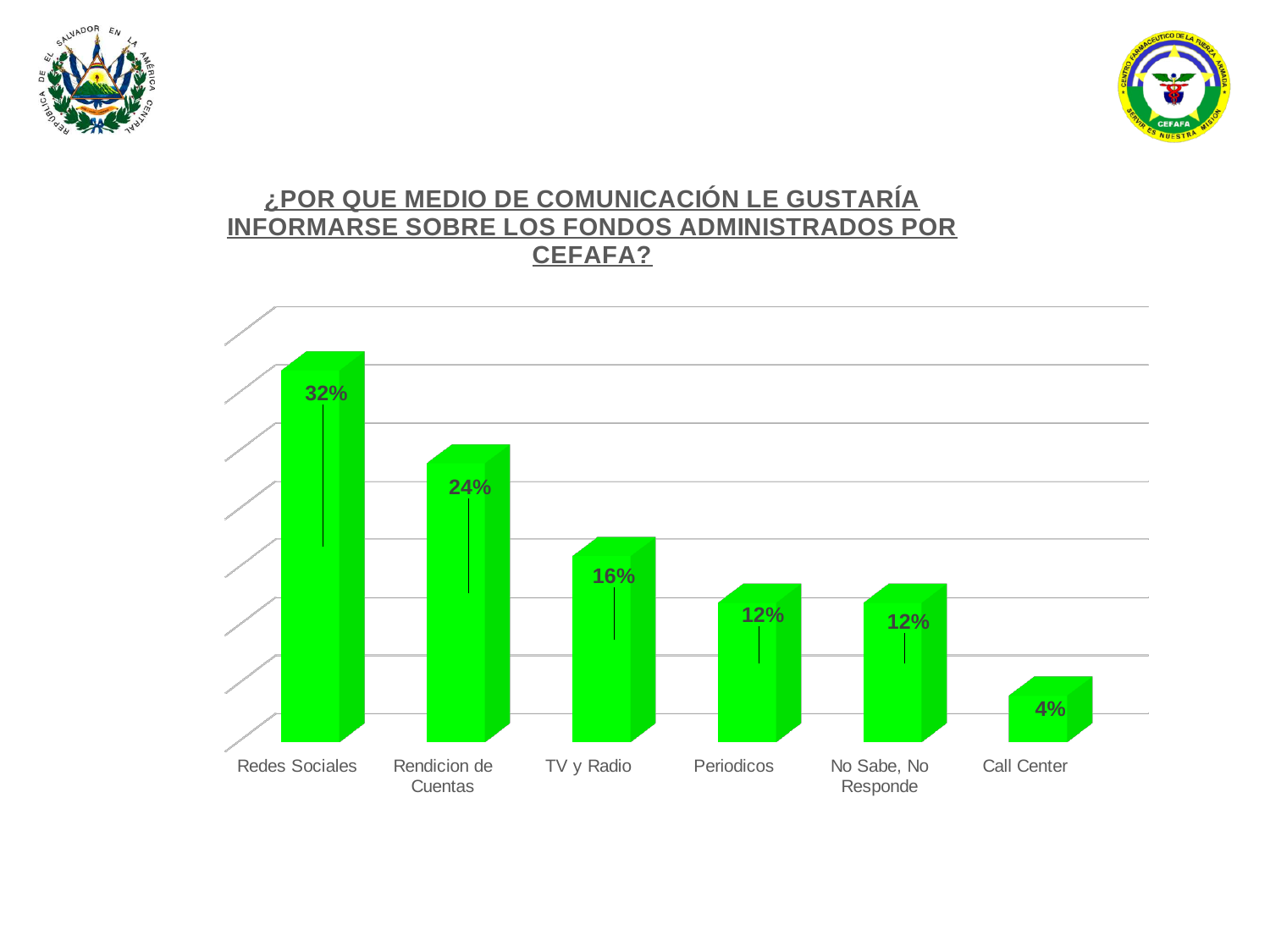
Which category has the lowest value? Call Center Which category has the highest value? Redes Sociales Which is larger, the value for Rendicion de Cuentas or the value for Periodicos? Rendicion de Cuentas What is the value for Call Center? 4% What is the value for Redes Sociales? 32% How many categories are shown in the chart? 6 What is the value for Rendicion de Cuentas? 24% What kind of chart is shown on the slide? Bar chart What is the difference between the values for TV y Radio and Call Center? 12% What is the value for TV y Radio? 16% Do the values generally rise or fall from left to right along the x axis? Fall What is the difference between the values for Redes Sociales and Rendicion de Cuentas? 8%